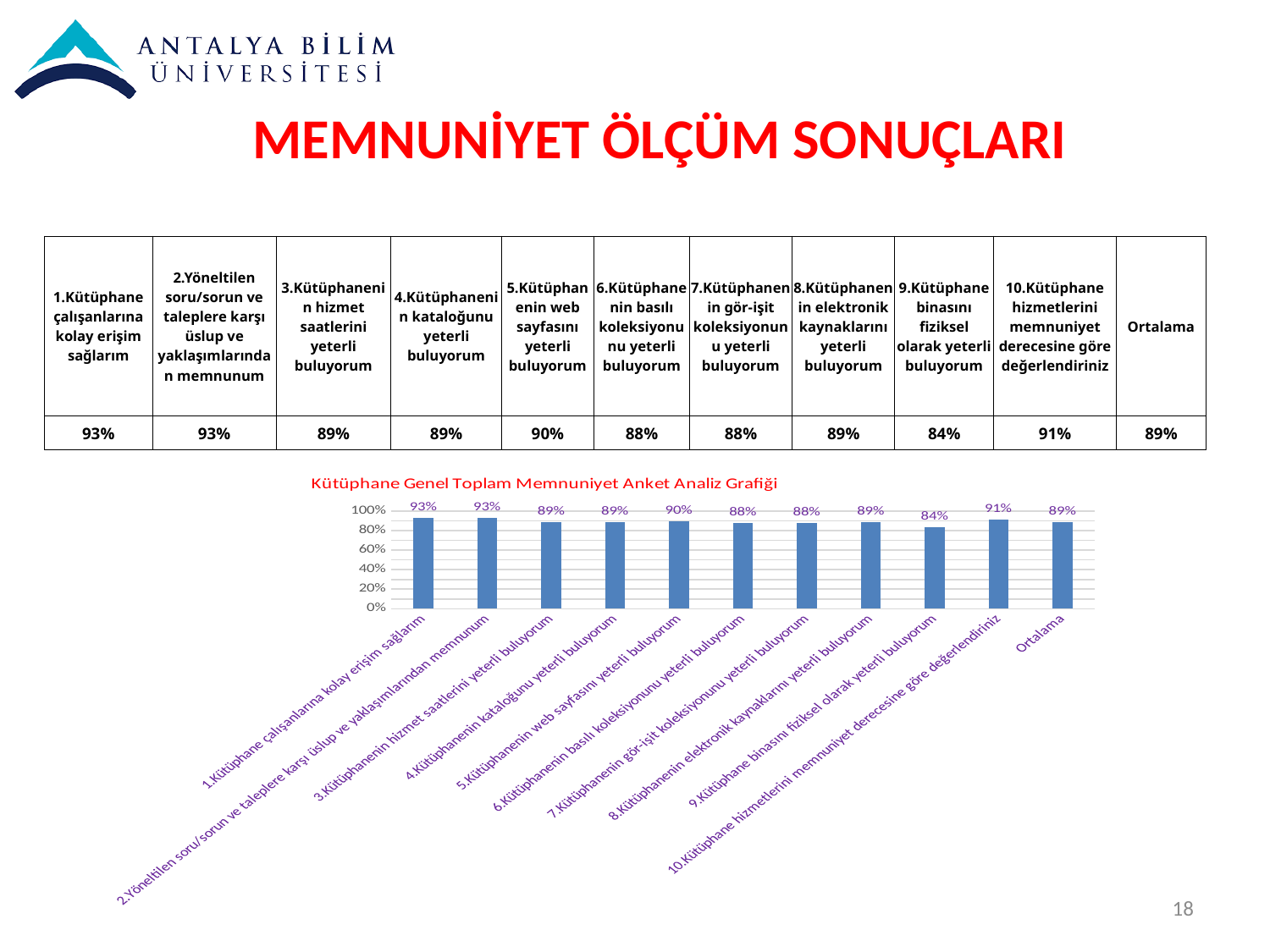
What is the value for "5.Kütüphanenin web sayfasını yeterli buluyorum" in the chart? 90% Is the value for "6.Kütüphanenin basılı koleksiyonunu yeterli buluyorum" greater or less than 60%? greater Which is larger: the value for "5.Kütüphanenin web sayfasını yeterli buluyorum" or the value for "9.Kütüphane binasını fiziksel olarak yeterli buluyorum"? 5.Kütüphanenin web sayfasını yeterli buluyorum Which category has the lowest value in the chart? 9.Kütüphane binasını fiziksel olarak yeterli buluyorum What is the difference between the value for "10.Kütüphane hizmetlerini memnuniyet derecesine göre değerlendiriniz" and the value for "Ortalama"? 2 percentage points What is the value for "Ortalama" in the chart? 89% How many bars are plotted in the chart? 11 What is the value for "10.Kütüphane hizmetlerini memnuniyet derecesine göre değerlendiriniz" in the chart? 91% What is the title of the chart? Kütüphane Genel Toplam Memnuniyet Anket Analiz Grafiği What kind of chart is shown on the slide? Bar chart What is the value for "9.Kütüphane binasını fiziksel olarak yeterli buluyorum" in the chart? 84% What is the difference between the value for "1.Kütüphane çalışanlarına kolay erişim sağlarım" and the value for "9.Kütüphane binasını fiziksel olarak yeterli buluyorum"? 9 percentage points